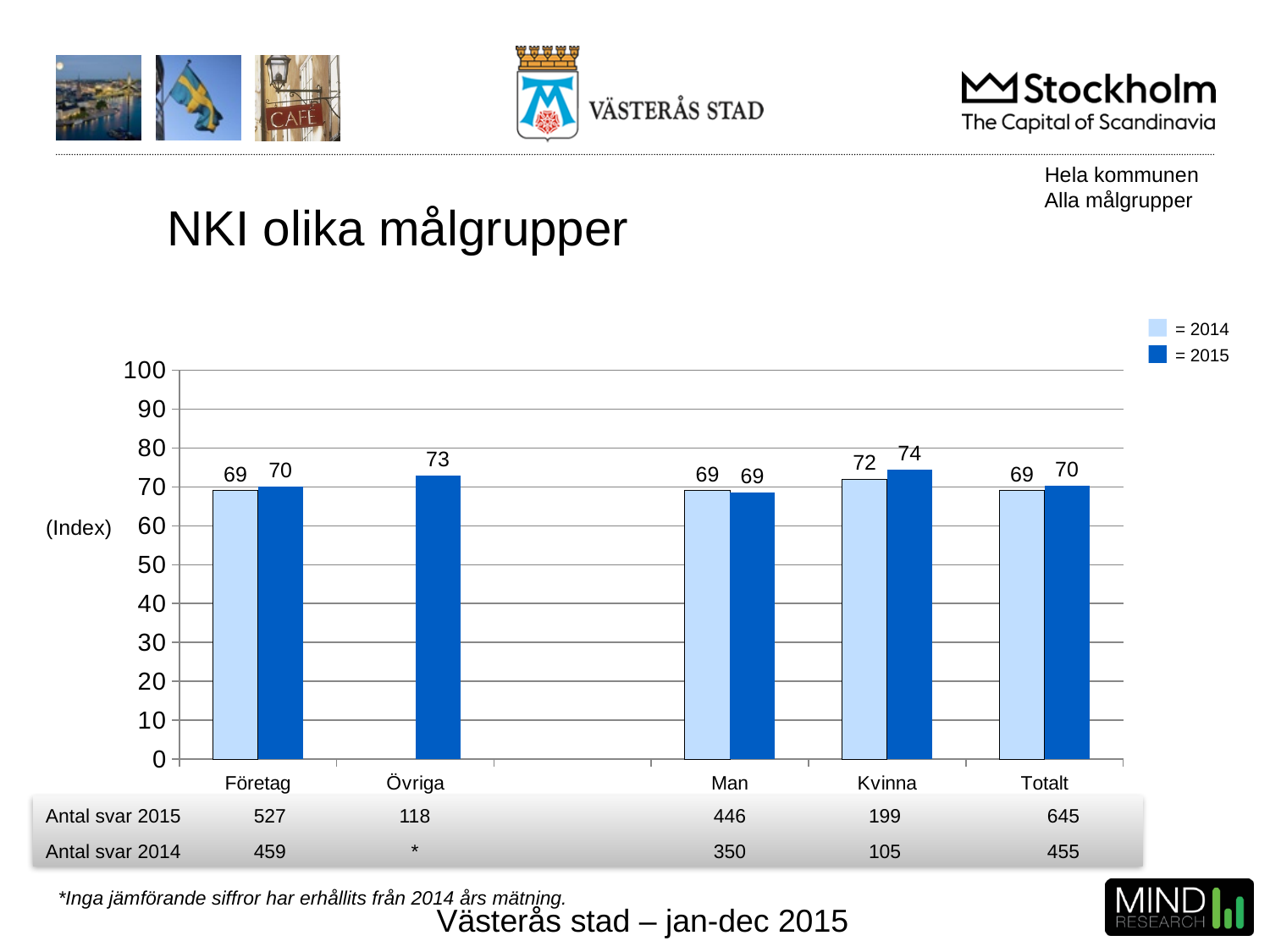
What is the 2015 NKI value for Kvinna? 74 What is the title of the chart? NKI olika målgrupper Is the 2015 value for Totalt greater or less than 60? greater What kind of chart is shown on the slide? bar chart How many categories are shown on the x axis of the chart? 5 Which category has no 2014 bar in the chart? Övriga How many series does the legend list? 2 Which is larger, the 2015 value for Övriga or the 2015 value for Man? Övriga What is the difference between the 2015 and 2014 NKI values for Kvinna? 2 What is the 2014 NKI value for Företag? 69 Which category has the highest 2015 NKI value? Kvinna What is the 2015 NKI value for Övriga? 73